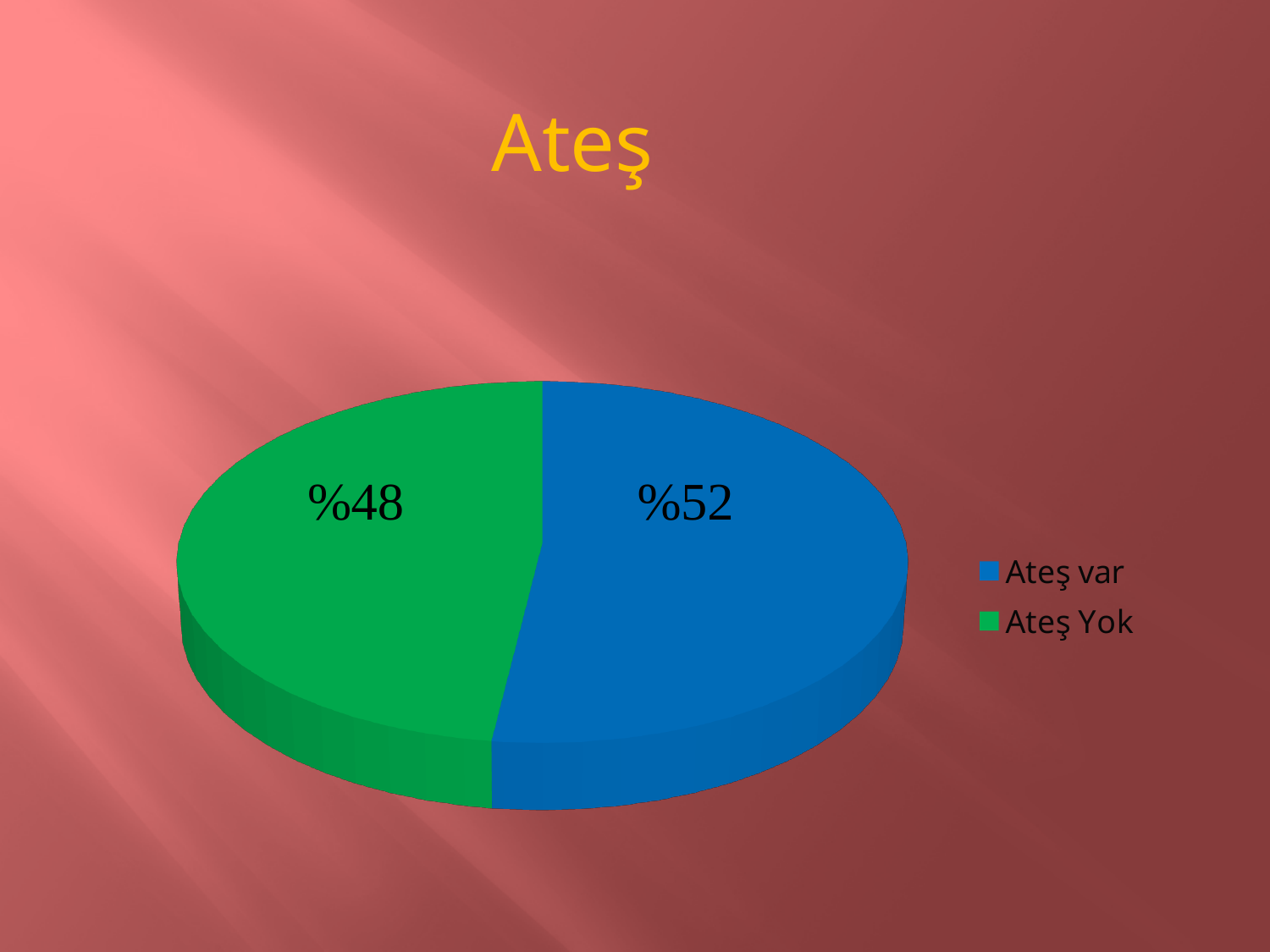
What percentage of the pie chart is labelled 'Ateş var'? %52 What is the title of the slide? Ateş What is the difference in percentage points between the 'Ateş var' and 'Ateş Yok' slices? 4 How many entries does the legend list? 2 What percentage of the pie chart is labelled 'Ateş Yok'? %48 Which slice of the pie chart is the largest? Ateş var What kind of chart is shown on the slide? Pie chart Is the 'Ateş var' slice greater or less than half of the pie? greater How many slices does the pie chart have? 2 Which is larger, the 'Ateş var' slice or the 'Ateş Yok' slice? Ateş var What colour is the 'Ateş Yok' slice? Green Which slice of the pie chart is the smallest? Ateş Yok